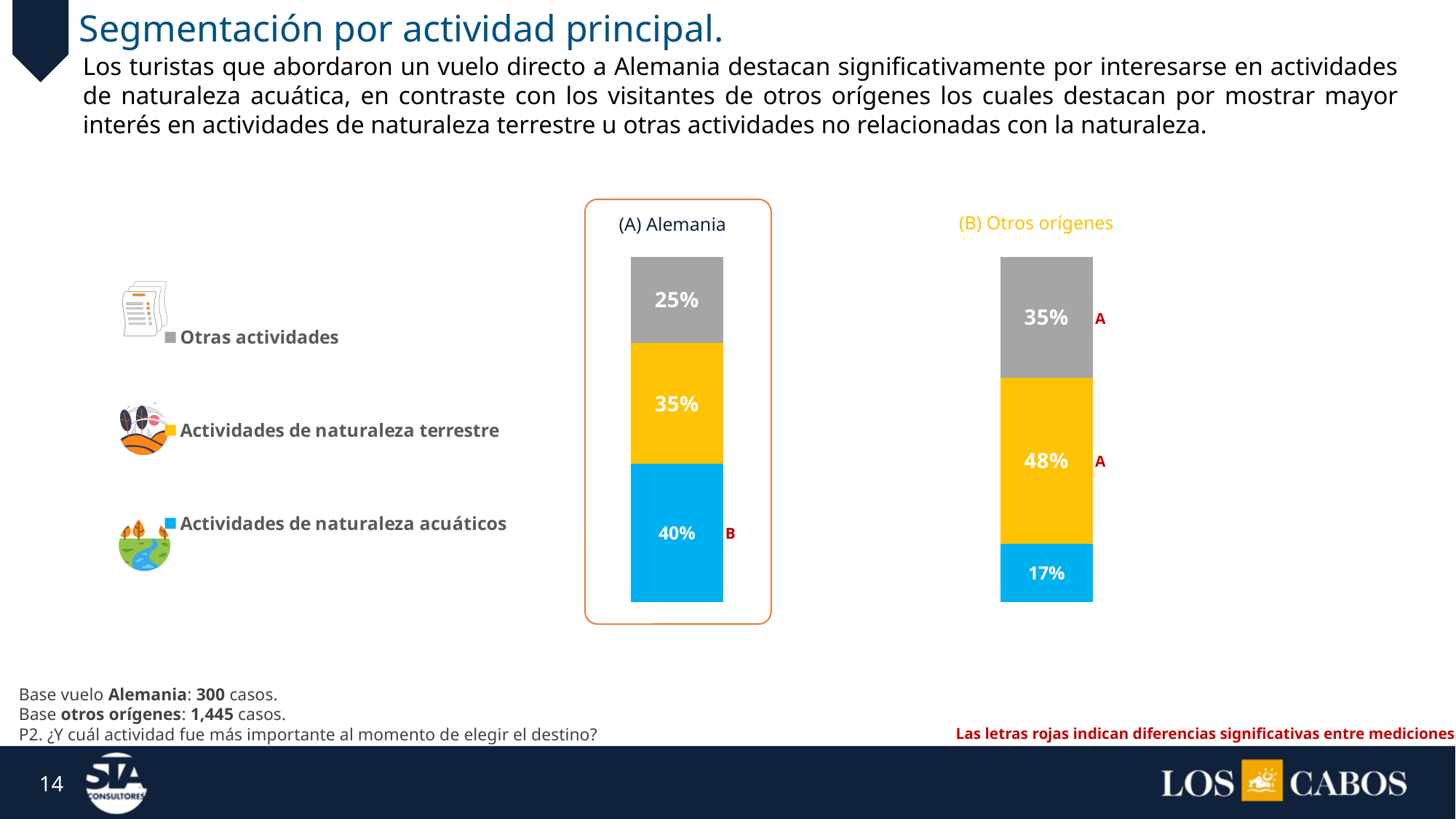
Which activity has the largest share in the Alemania bar? Actividades de naturaleza acuáticos What is the value for Otras actividades in the Otros orígenes bar? 35% Which activity has the smallest share in the Otros orígenes bar? Actividades de naturaleza acuáticos How many bars are shown in the chart? 2 What is the difference in percentage points between Alemania and Otros orígenes for Actividades de naturaleza acuáticos? 23 What type of chart is shown on the slide? Stacked bar chart Which colour represents Actividades de naturaleza terrestre in the chart? Yellow What is the value for Actividades de naturaleza acuáticos in the Otros orígenes bar? 17% Which group has a higher share for Otras actividades, Alemania or Otros orígenes? Otros orígenes What percentage of Otros orígenes tourists chose Actividades de naturaleza terrestre? 48% What percentage of Alemania tourists chose Actividades de naturaleza acuáticos? 40% How many series does the legend list? 3